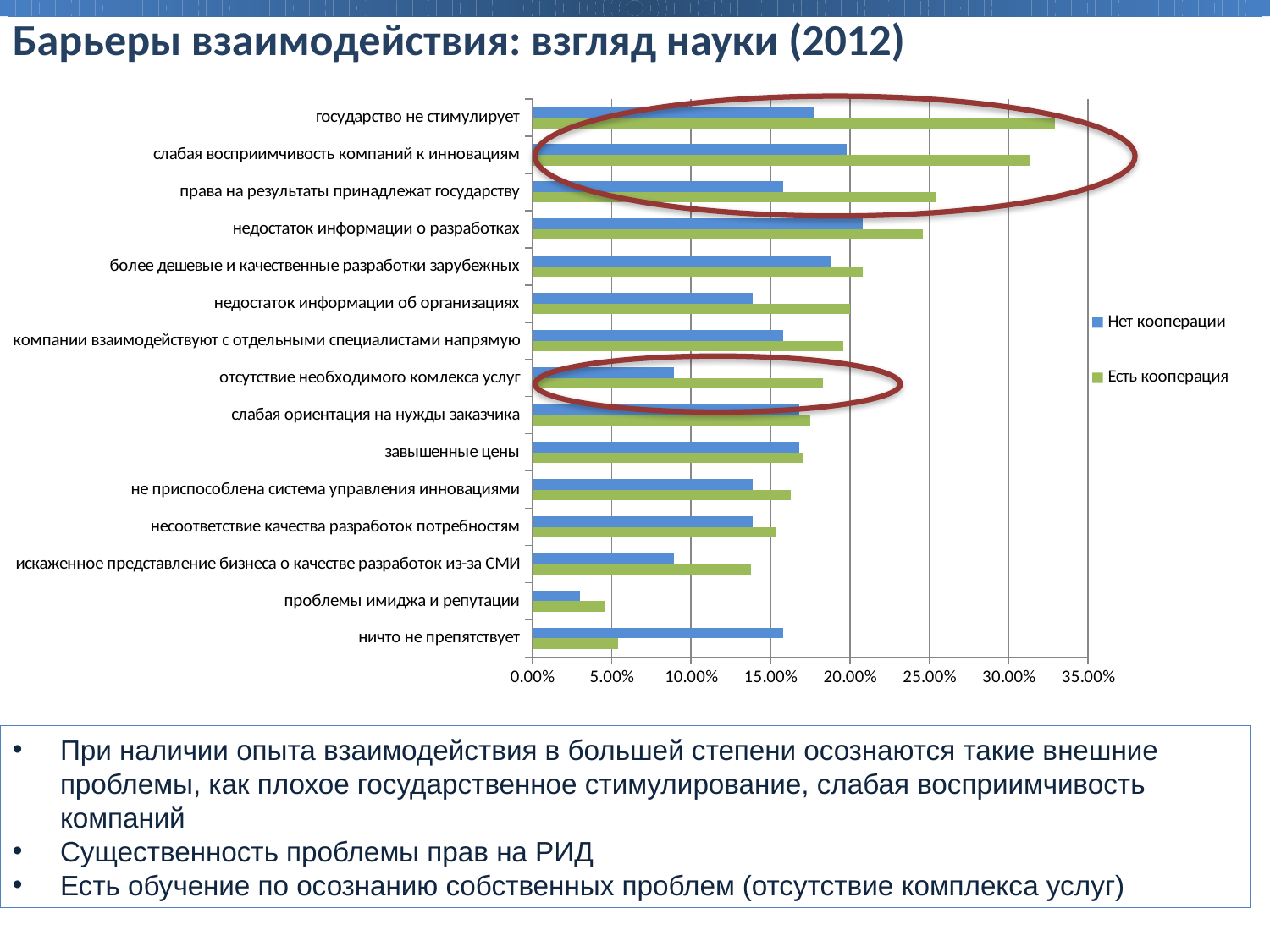
Is the value of "Есть кооперация" for "государство не стимулирует" greater or less than 30.00%? greater What kind of chart is shown on the slide? bar chart Is the value of "Нет кооперации" for "отсутствие необходимого комлекса услуг" greater or less than 10.00%? less Which category has the lowest value for the series "Есть кооперация"? проблемы имиджа и репутации For the category "ничто не препятствует", which series has the larger value: "Нет кооперации" or "Есть кооперация"? Нет кооперации Which category has the highest value for the series "Есть кооперация"? государство не стимулирует Which colour represents the series "Нет кооперации" in the legend? blue For the category "отсутствие необходимого комлекса услуг", which series has the larger value: "Нет кооперации" or "Есть кооперация"? Есть кооперация How many categories are plotted on the chart? 15 Which category has the lowest value for the series "Нет кооперации"? проблемы имиджа и репутации How many series does the legend list? 2 Is the value of "Есть кооперация" for "проблемы имиджа и репутации" greater or less than 5.00%? less